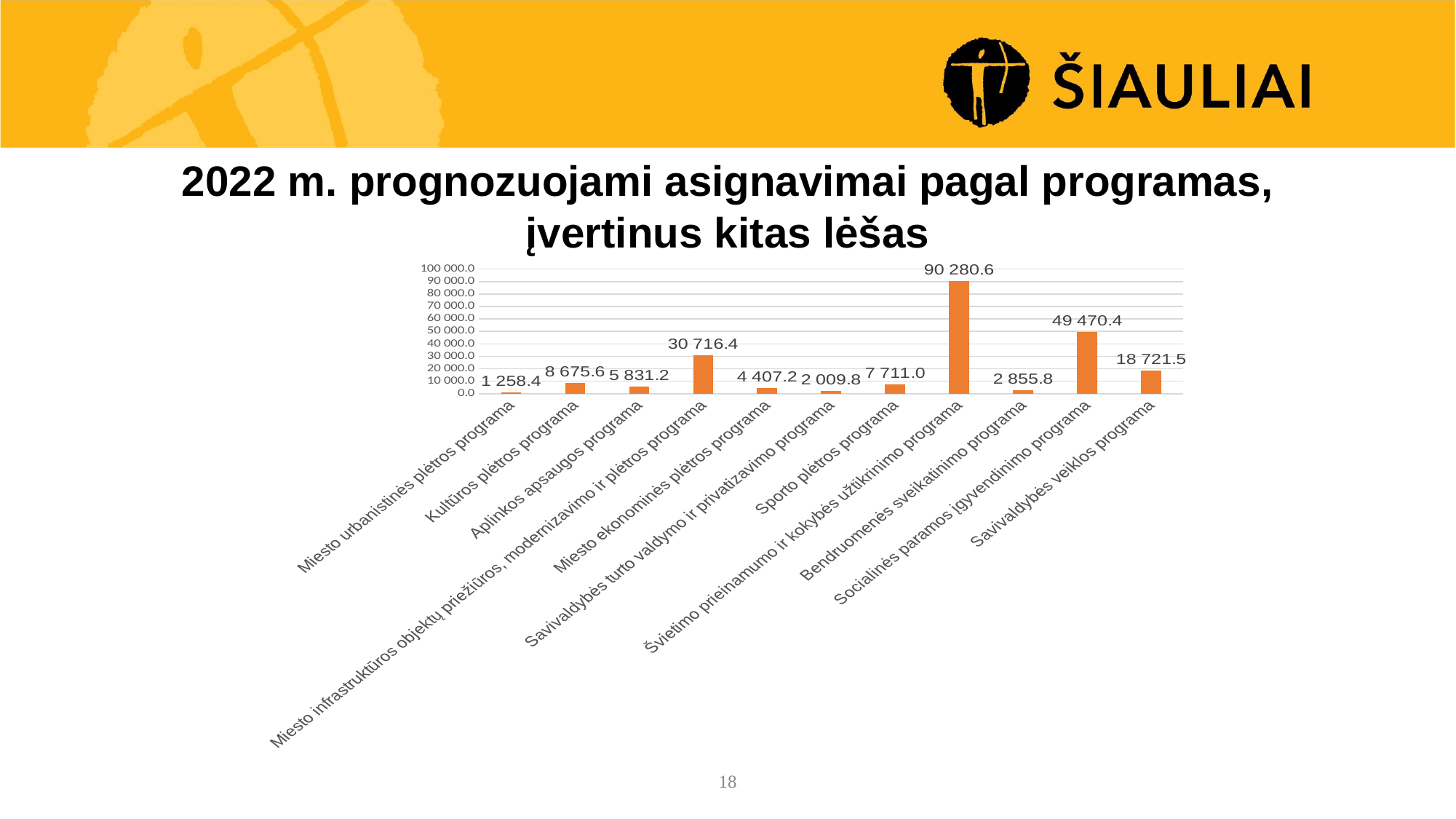
Is the value for Miesto infrastruktūros objektų priežiūros, modernizavimo ir plėtros programa greater or less than 20 000.0? greater What kind of chart is shown on the slide? Bar chart Which is larger: the value for Sporto plėtros programa or the value for Miesto ekonominės plėtros programa? Sporto plėtros programa What is the value for Savivaldybės veiklos programa? 18 721.5 What is the difference between the values for Švietimo prieinamumo ir kokybės užtikrinimo programa and Socialinės paramos įgyvendinimo programa? 40 810.2 Which programme has the highest value? Švietimo prieinamumo ir kokybės užtikrinimo programa What is the value for Švietimo prieinamumo ir kokybės užtikrinimo programa? 90 280.6 What is the value for Miesto urbanistinės plėtros programa? 1 258.4 What is the value for Socialinės paramos įgyvendinimo programa? 49 470.4 Which programme has the lowest value? Miesto urbanistinės plėtros programa What is the difference between the values for Kultūros plėtros programa and Aplinkos apsaugos programa? 2 844.4 How many programmes are shown on the chart? 11